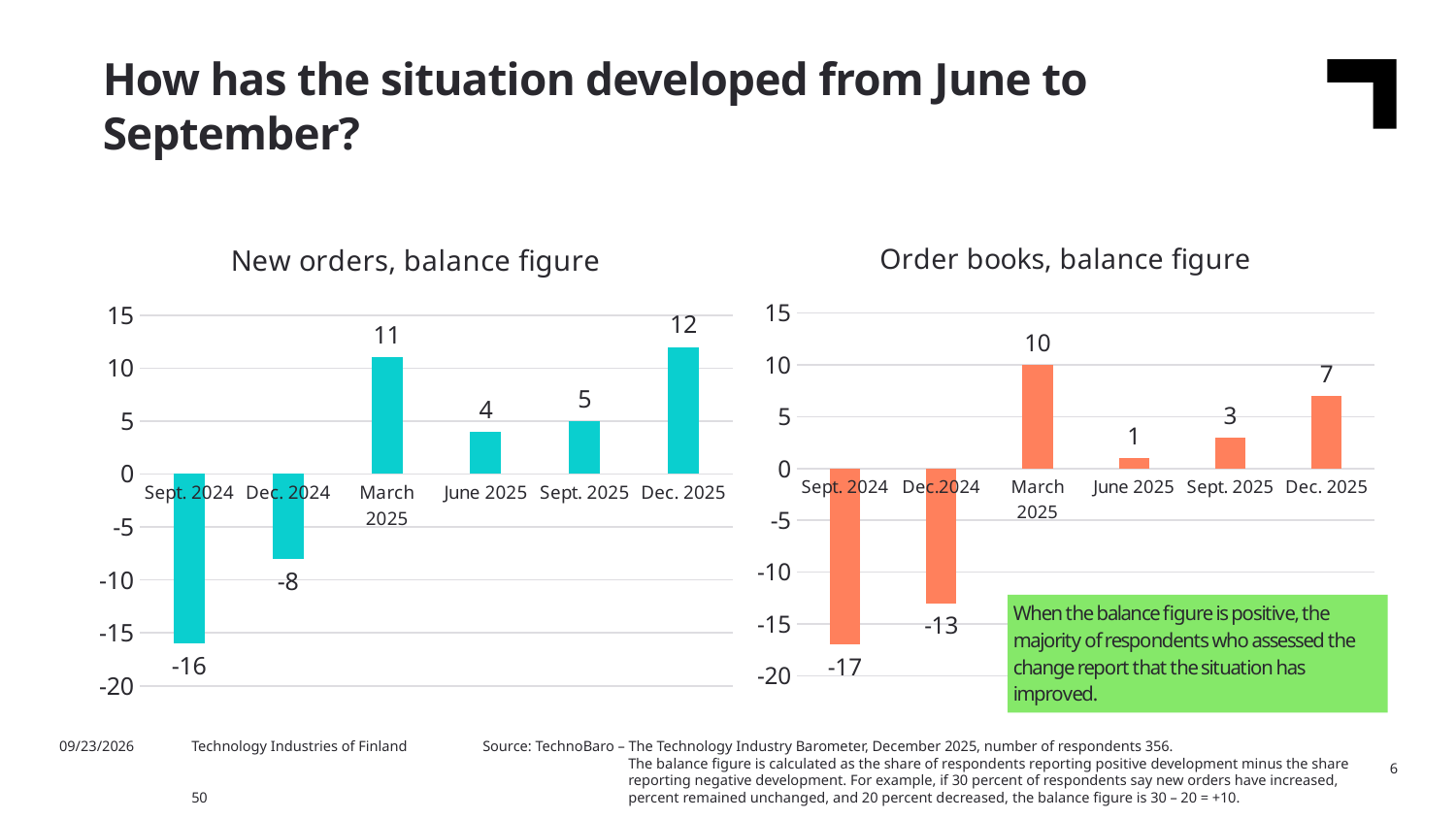
In the 'Order books, balance figure' chart, which is larger, the value for March 2025 or the value for Dec. 2025? March 2025 In the 'Order books, balance figure' chart, what is the value for March 2025? 10 In the 'New orders, balance figure' chart, what is the value for Dec. 2025? 12 In the 'New orders, balance figure' chart, do the values rise or fall from June 2025 to Dec. 2025? Rise What kind of chart is the 'Order books, balance figure' chart? Bar chart In the 'New orders, balance figure' chart, what is the difference between the values for Dec. 2025 and Sept. 2025? 7 In the 'Order books, balance figure' chart, what is the value for June 2025? 1 In the 'Order books, balance figure' chart, what is the difference between the values for Dec. 2025 and Sept. 2025? 4 In the 'New orders, balance figure' chart, what is the value for Sept. 2024? -16 How many periods are shown on the x axis of the 'New orders, balance figure' chart? 6 In the 'Order books, balance figure' chart, which period has the lowest value? Sept. 2024 In the 'New orders, balance figure' chart, which period has the highest value? Dec. 2025